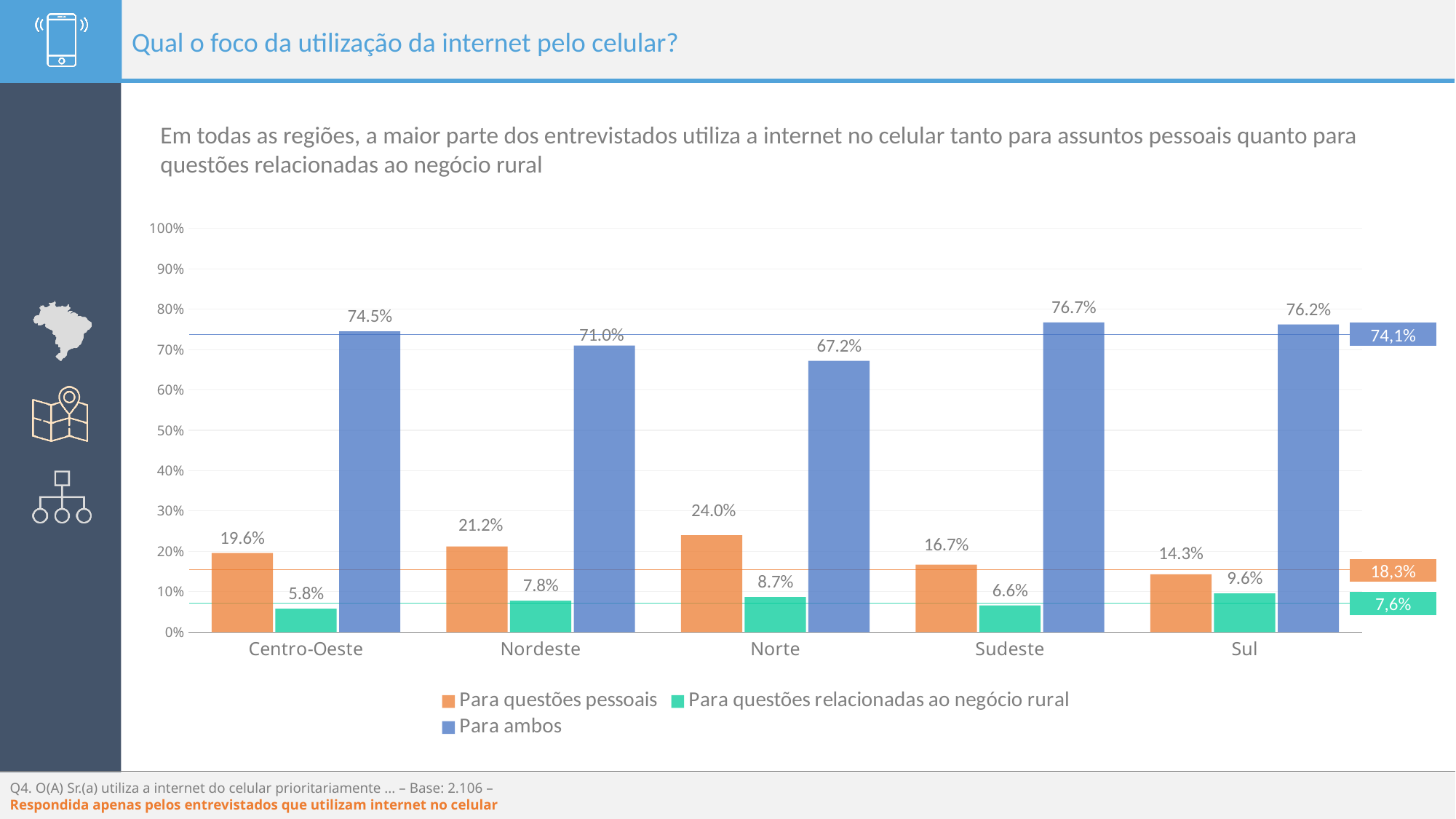
What is the value for "Para questões pessoais" in Norte? 24.0% What kind of chart is shown on the slide? Bar chart Which region has the highest value for "Para ambos"? Sudeste What is the value for "Para questões relacionadas ao negócio rural" in Sul? 9.6% What is the value for "Para ambos" in Centro-Oeste? 74.5% Is the value for "Para ambos" in Norte greater or less than 70%? less Which region has the lowest value for "Para questões pessoais"? Sul How many series does the legend list? 3 How many regions are shown on the x axis? 5 Which is larger: "Para questões relacionadas ao negócio rural" in Nordeste or in Centro-Oeste? Nordeste What is the difference between the "Para ambos" values for Sudeste and Norte? 9.5% What value is shown in the blue label at the right end of the "Para ambos" reference line? 74,1%